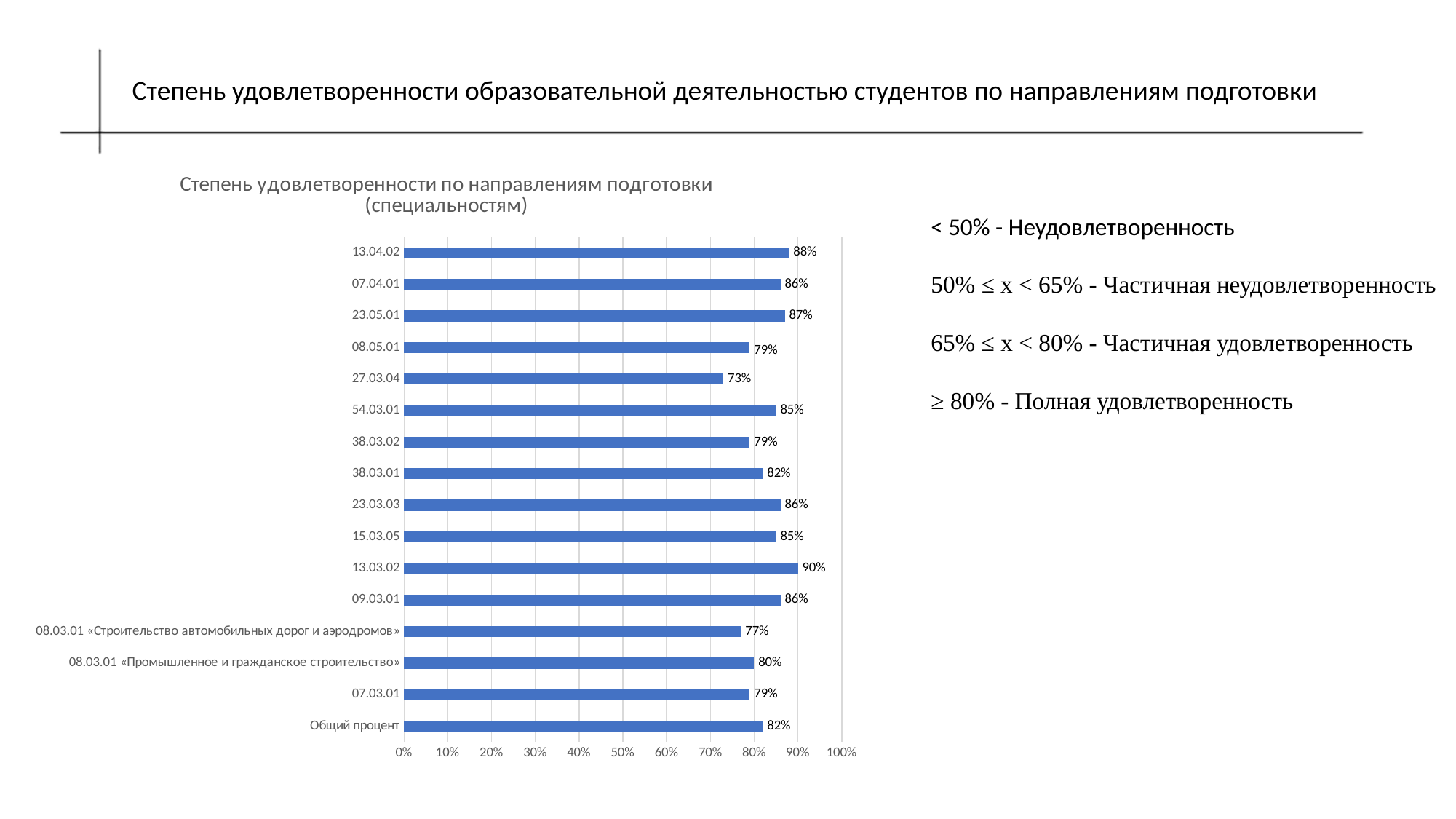
Which is larger, the value for 23.05.01 or the value for 08.05.01? 23.05.01 How many categories are shown on the chart? 16 What is the value for 08.03.01 «Строительство автомобильных дорог и аэродромов»? 77% What kind of chart is shown on the slide? bar chart What is the value for 13.04.02? 88% What is the title of the chart? Степень удовлетворенности по направлениям подготовки (специальностям) Is the value for 54.03.01 greater or less than 80%? greater Which category has the highest value? 13.03.02 Which category has the lowest value? 27.03.04 What is the value for 27.03.04? 73% What is the value for Общий процент? 82% What is the difference between the values for 13.03.02 and 27.03.04? 17%